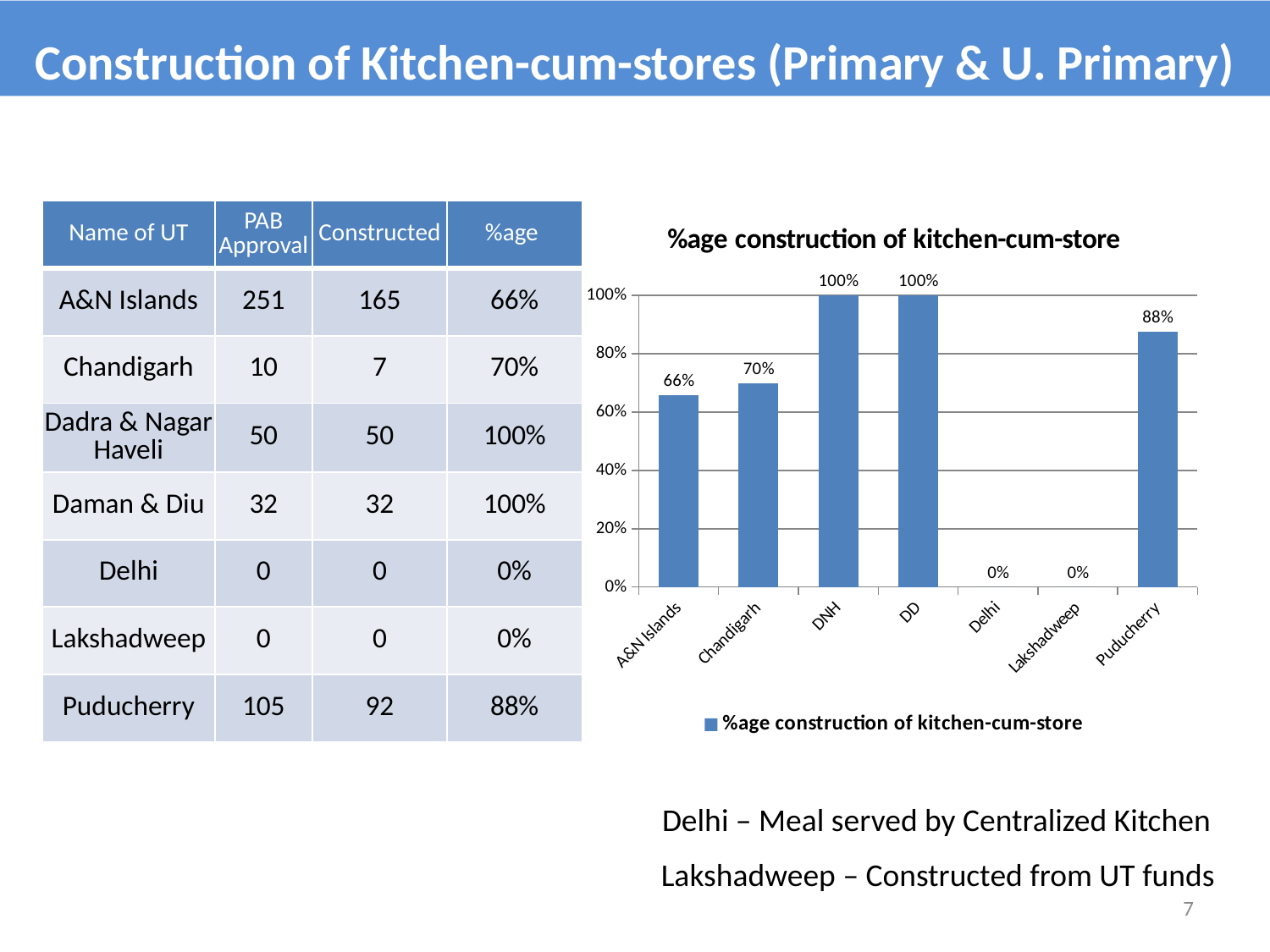
What is the value for Puducherry in the chart? 88% What is the title of the chart? %age construction of kitchen-cum-store What kind of chart is shown on the slide? bar chart Is the value for Puducherry greater or less than 80%? greater What is the difference between the values for DNH and A&N Islands? 34% What is the value for Chandigarh in the chart? 70% How many categories are shown on the x axis of the chart? 7 Which category has the lowest value in the chart, Delhi or Puducherry? Delhi Is the value for Chandigarh greater or less than 80%? less What is the difference between the values for Puducherry and Chandigarh? 18% How many series does the chart legend list? 1 What is the value for A&N Islands in the chart? 66%